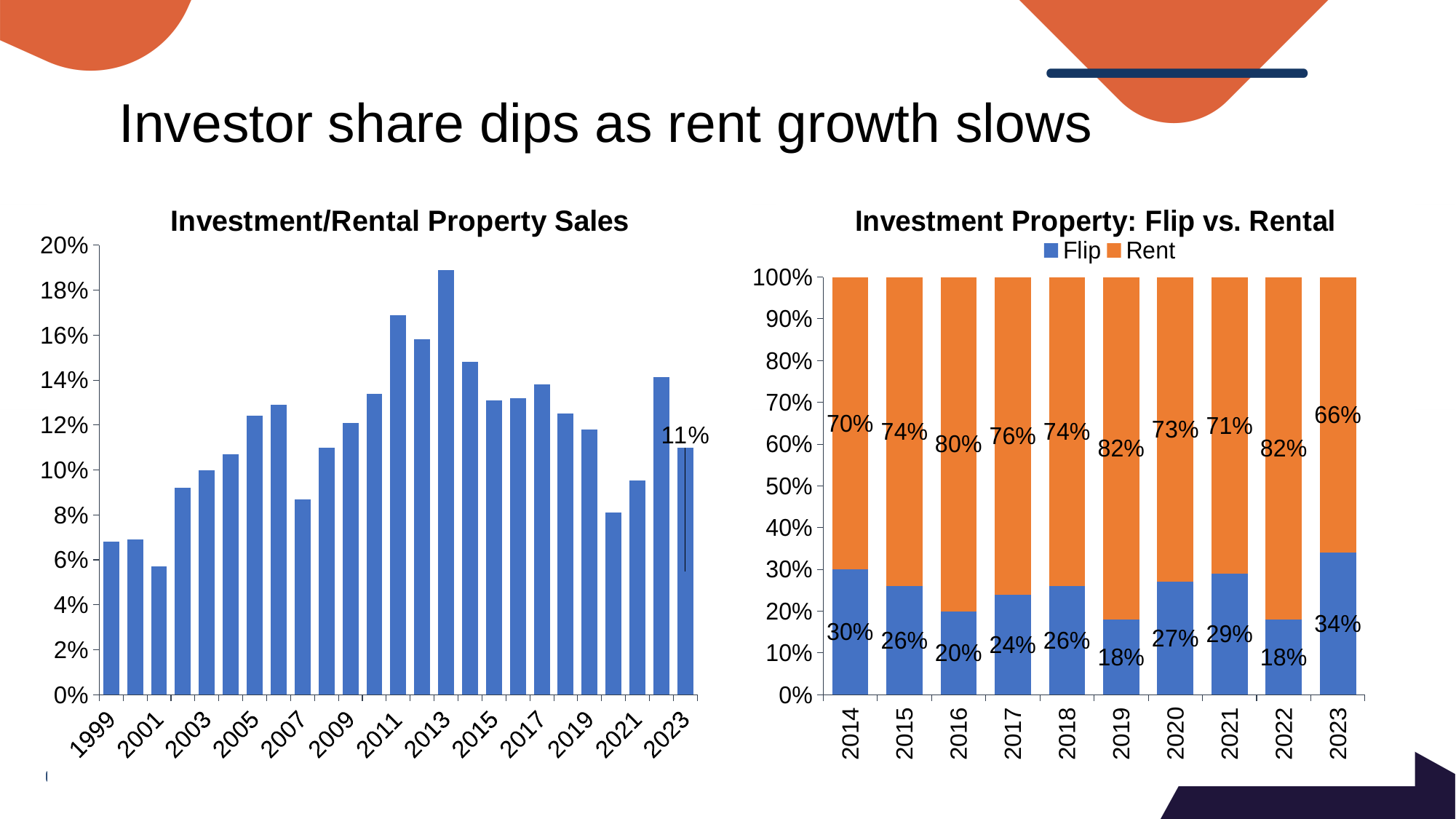
In the Investment/Rental Property Sales chart, is the value for 2020 greater or less than 10%? less What kind of chart is the Investment/Rental Property Sales chart? bar chart In the Investment Property: Flip vs. Rental chart, what is the Rent share for 2019? 82% In the Investment/Rental Property Sales chart, which year has the highest value? 2013 How many series does the legend of the Investment Property: Flip vs. Rental chart list? 2 In the Investment Property: Flip vs. Rental chart, which year has the lowest Rent share? 2023 In the Investment Property: Flip vs. Rental chart, how many percentage points higher is the Rent share than the Flip share in 2016? 60 percentage points In the Investment Property: Flip vs. Rental chart, which year has the highest Flip share? 2023 In the Investment/Rental Property Sales chart, is the value for 2013 greater or less than 18%? greater In the Investment Property: Flip vs. Rental chart, what is the Flip share for 2023? 34% In the Investment/Rental Property Sales chart, what is the value for 2023? 11% In the Investment Property: Flip vs. Rental chart, how many years are shown on the x axis? 10